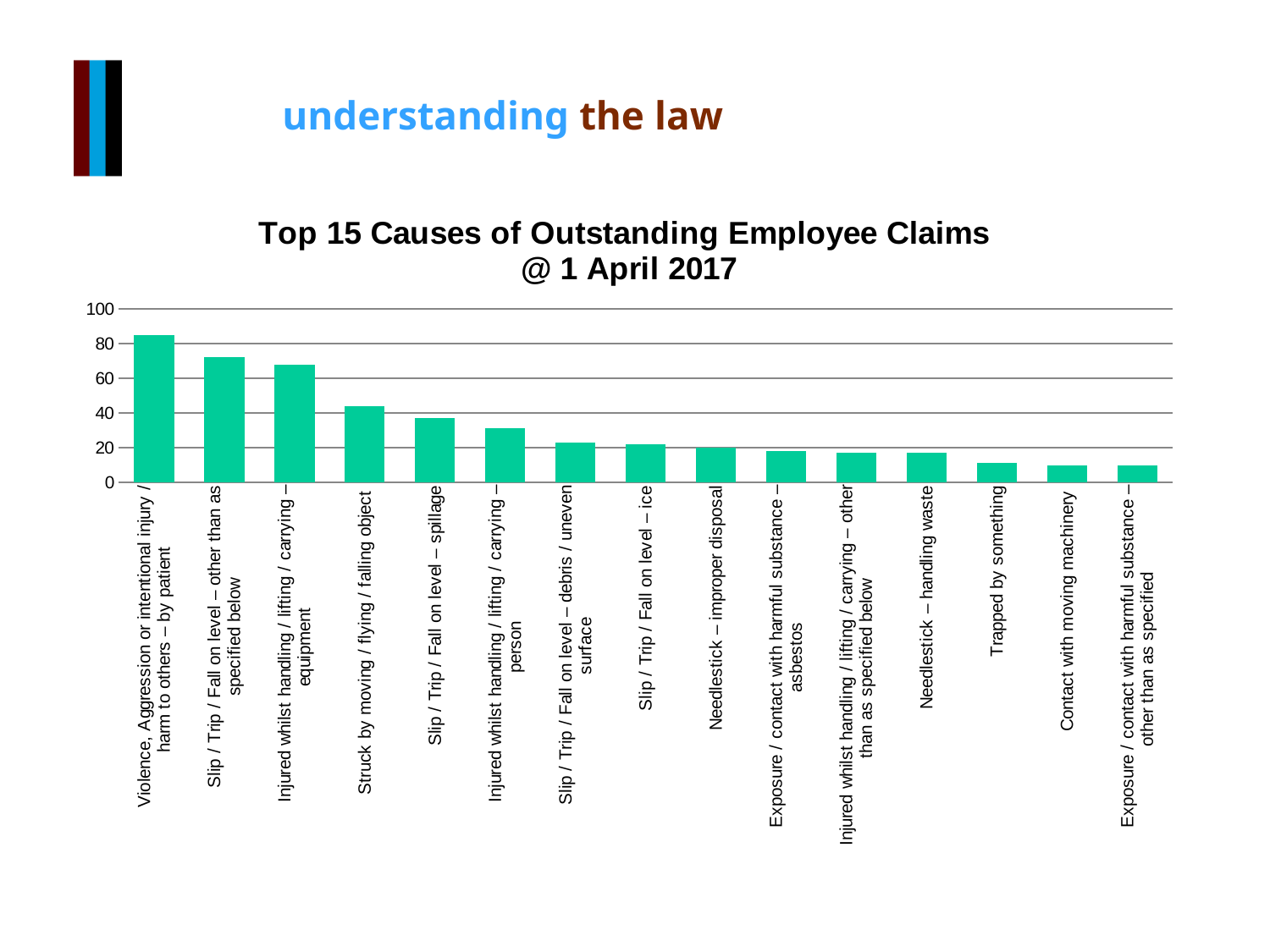
What is the title of the chart? Top 15 Causes of Outstanding Employee Claims @ 1 April 2017 What kind of chart is shown on the slide? bar chart How many categories (bars) are plotted in the chart? 15 Is the value for 'Slip / Trip / Fall on level – other than as specified below' greater or less than 60? greater Is the value for 'Trapped by something' greater or less than 20? less Is the value for 'Slip / Trip / Fall on level – spillage' greater or less than 40? less Which category has the highest value in the chart? Violence, Aggression or intentional injury / harm to others – by patient Which is larger: the value for 'Injured whilst handling / lifting / carrying – equipment' or the value for 'Struck by moving / flying / falling object'? Injured whilst handling / lifting / carrying – equipment Do the bar values rise or fall from left to right along the x axis? fall Which is larger: the value for 'Needlestick – improper disposal' or the value for 'Trapped by something'? Needlestick – improper disposal